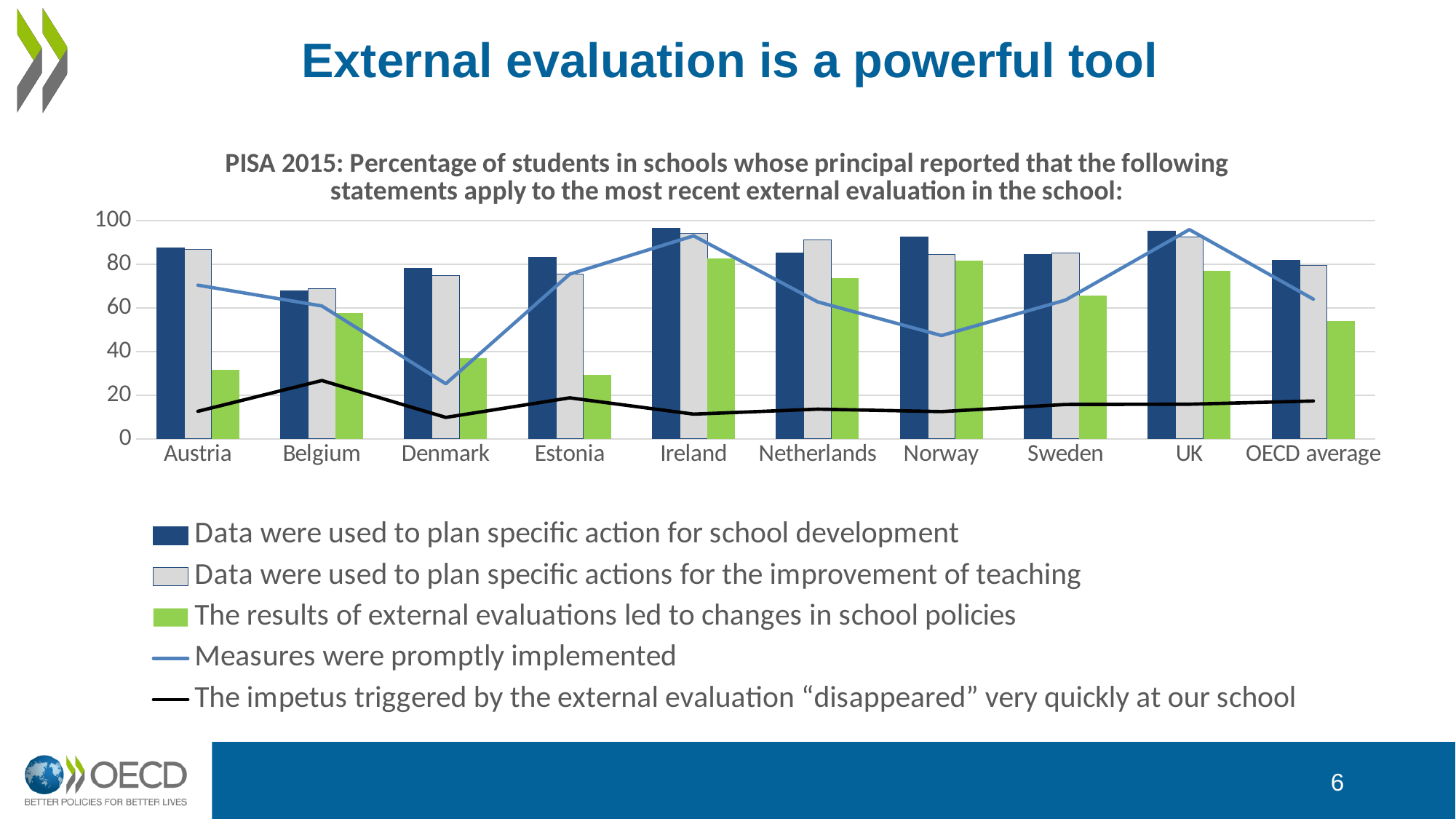
For Denmark, which is larger: the 'Measures were promptly implemented' line or the 'The results of external evaluations led to changes in school policies' bar? The results of external evaluations led to changes in school policies What kind of chart is shown on the slide? Combined bar and line chart Which category has the lowest value for the 'Measures were promptly implemented' line? Denmark Is the value for Ireland in 'Data were used to plan specific action for school development' greater or less than 90? greater Is the value for Norway on the 'Measures were promptly implemented' line greater or less than 60? less How many countries or categories are shown on the x axis of the chart? 10 Which category has the highest value for the line 'The impetus triggered by the external evaluation "disappeared" very quickly at our school'? Belgium Which series is drawn as a black line in the chart? The impetus triggered by the external evaluation "disappeared" very quickly at our school Is the value for the OECD average in 'The results of external evaluations led to changes in school policies' greater or less than 40? greater How many series does the chart's legend list? 5 Which category has the lowest value for 'Data were used to plan specific action for school development'? Belgium